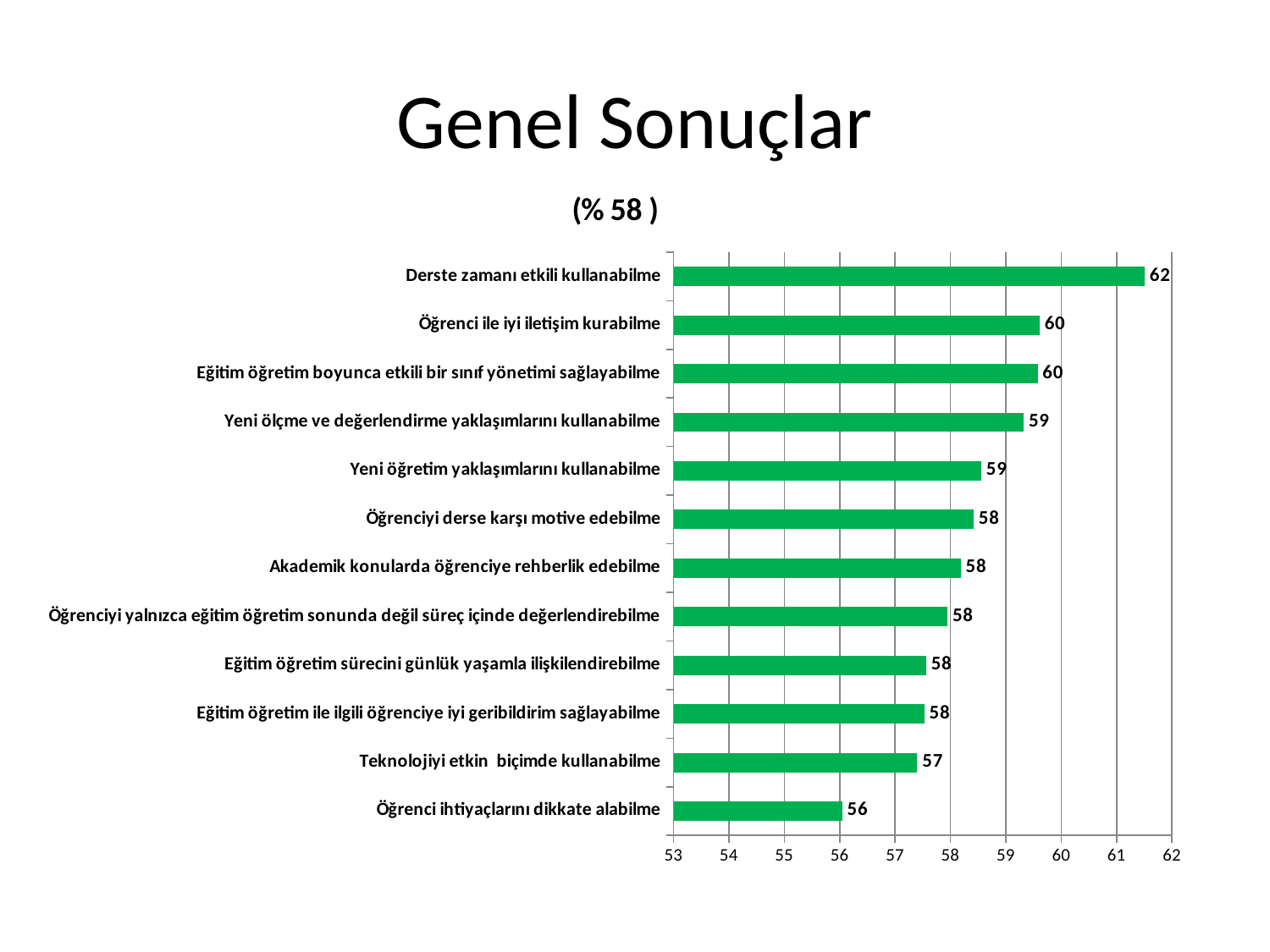
What is the value for "Derste zamanı etkili kullanabilme"? 62 What is the value for "Öğrenci ile iyi iletişim kurabilme"? 60 What is the value for "Teknolojiyi etkin biçimde kullanabilme"? 57 What kind of chart is shown on the slide? bar chart Is the value for "Öğrenci ihtiyaçlarını dikkate alabilme" greater or less than 58? less Which category has the highest value? Derste zamanı etkili kullanabilme Which is larger: the value for "Derste zamanı etkili kullanabilme" or the value for "Teknolojiyi etkin biçimde kullanabilme"? Derste zamanı etkili kullanabilme Which category has the lowest value? Öğrenci ihtiyaçlarını dikkate alabilme What is the title of the chart? (% 58 ) How many categories are shown in the chart? 12 What is the value for "Öğrenci ihtiyaçlarını dikkate alabilme"? 56 What is the difference between the values for "Derste zamanı etkili kullanabilme" and "Öğrenci ihtiyaçlarını dikkate alabilme"? 6